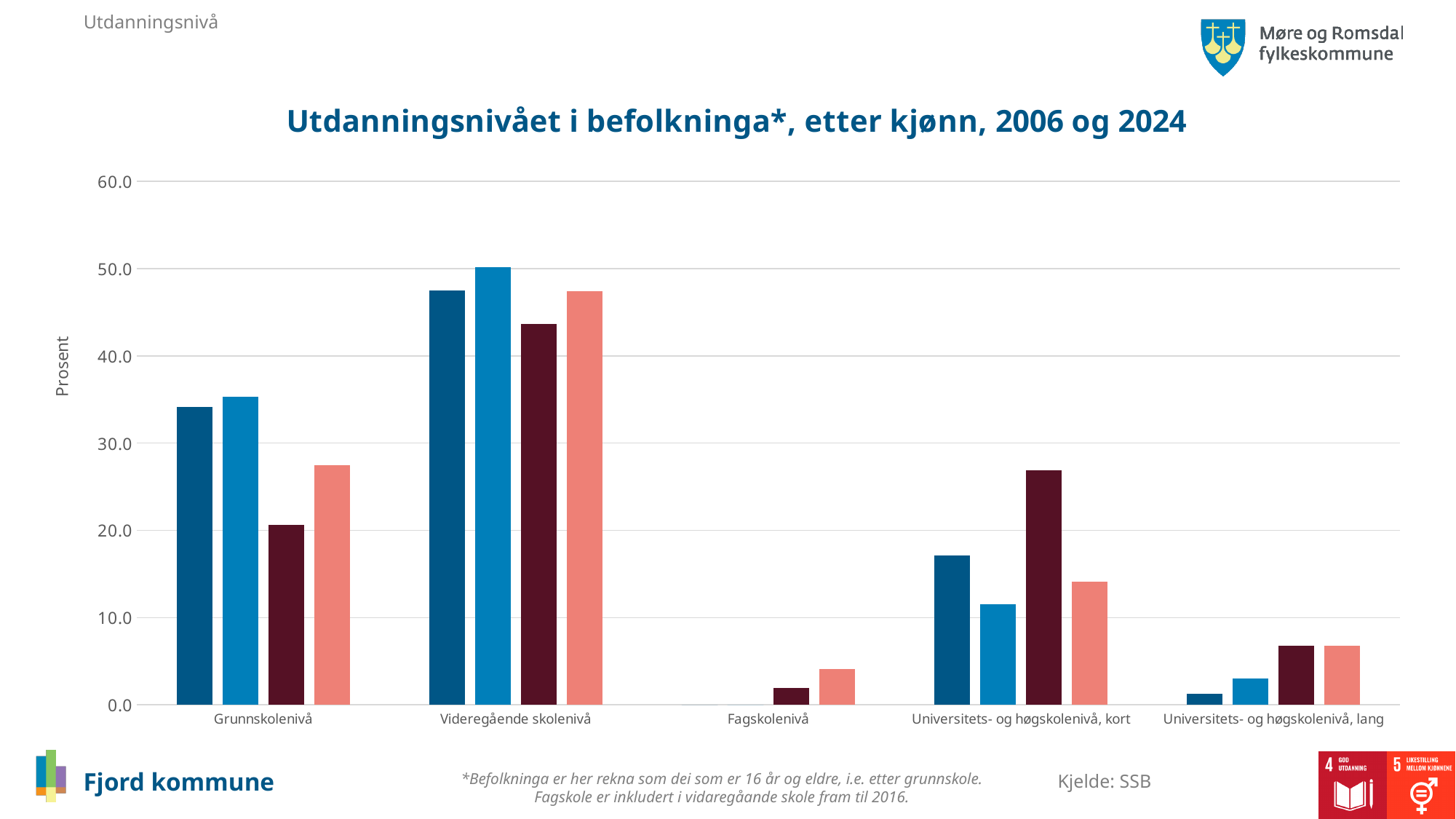
What kind of chart is shown on the slide? bar chart Is the value of the dark red bar for Videregående skolenivå greater or less than 40? greater Is the value of the first (dark blue) bar for Grunnskolenivå greater or less than 30? greater For Universitets- og høgskolenivå, kort, which is larger: the light blue bar or the dark red bar? the dark red bar Which category has the lowest bars overall? Fagskolenivå How many education-level categories are shown on the x axis? 5 Is the value of the salmon-coloured bar for Fagskolenivå greater or less than 10? less Which category has the tallest bars overall? Videregående skolenivå What is the title of the chart? Utdanningsnivået i befolkninga*, etter kjønn, 2006 og 2024 For Grunnskolenivå, which is larger: the dark red bar or the salmon-coloured bar? the salmon-coloured bar